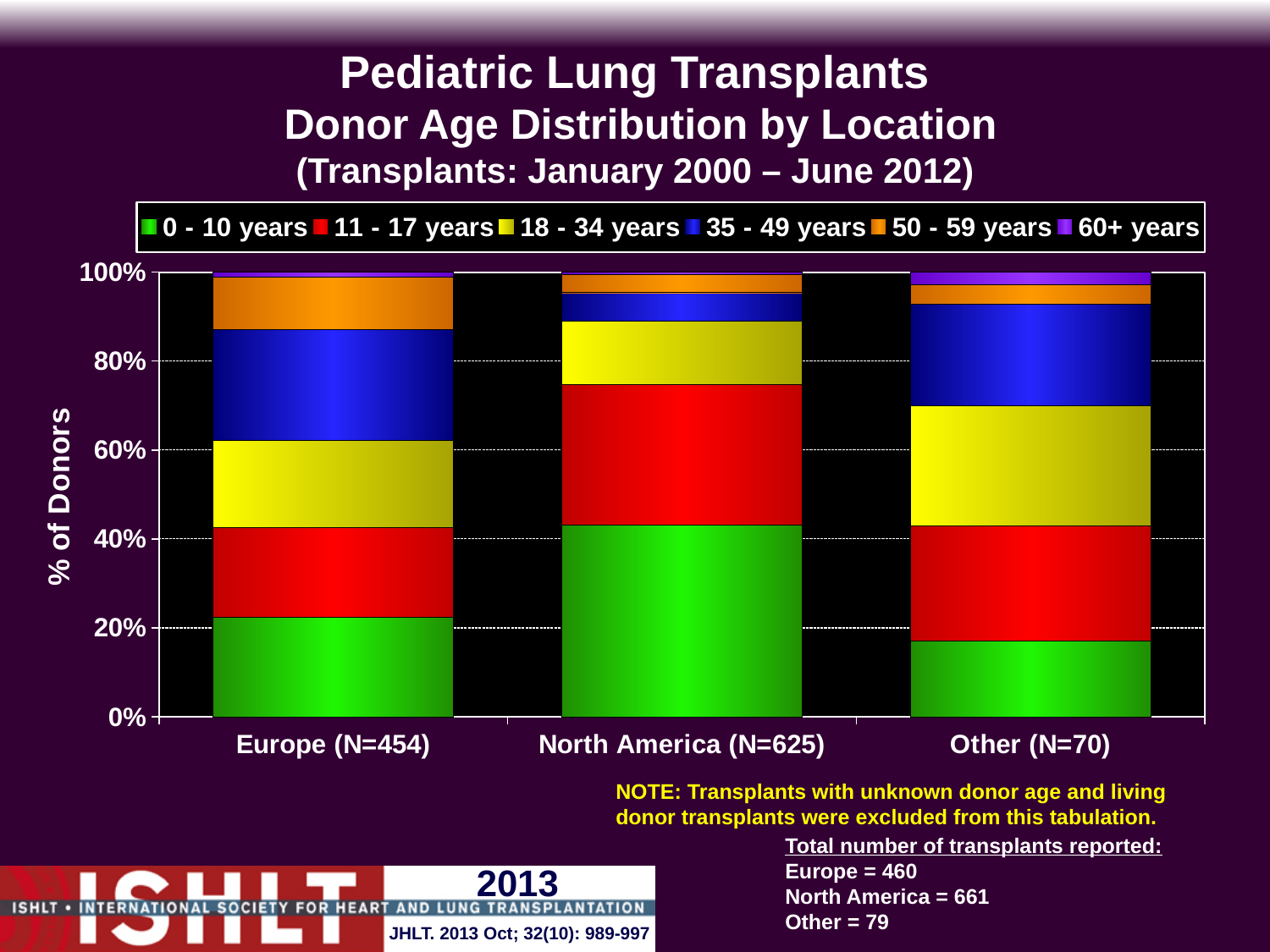
What is the label of the y axis? % of Donors Is the share of 0 - 10 years donors for Europe greater or less than 20%? greater Which location has the smallest share of donors aged 35 - 49 years? North America (N=625) What kind of chart is shown on the slide? stacked bar chart Is the share of 0 - 10 years donors for Other greater or less than 20%? less How many donor age groups does the legend list? 6 Which location has the smallest share of donors aged 0 - 10 years? Other (N=70) How many locations (categories) are shown on the x axis? 3 Which is larger: the 0 - 10 years share for Europe or for North America? North America What is the N value shown for Europe on the x axis? 454 Which location has the largest share of donors aged 0 - 10 years? North America (N=625) Is the share of 0 - 10 years donors for North America greater or less than 40%? greater